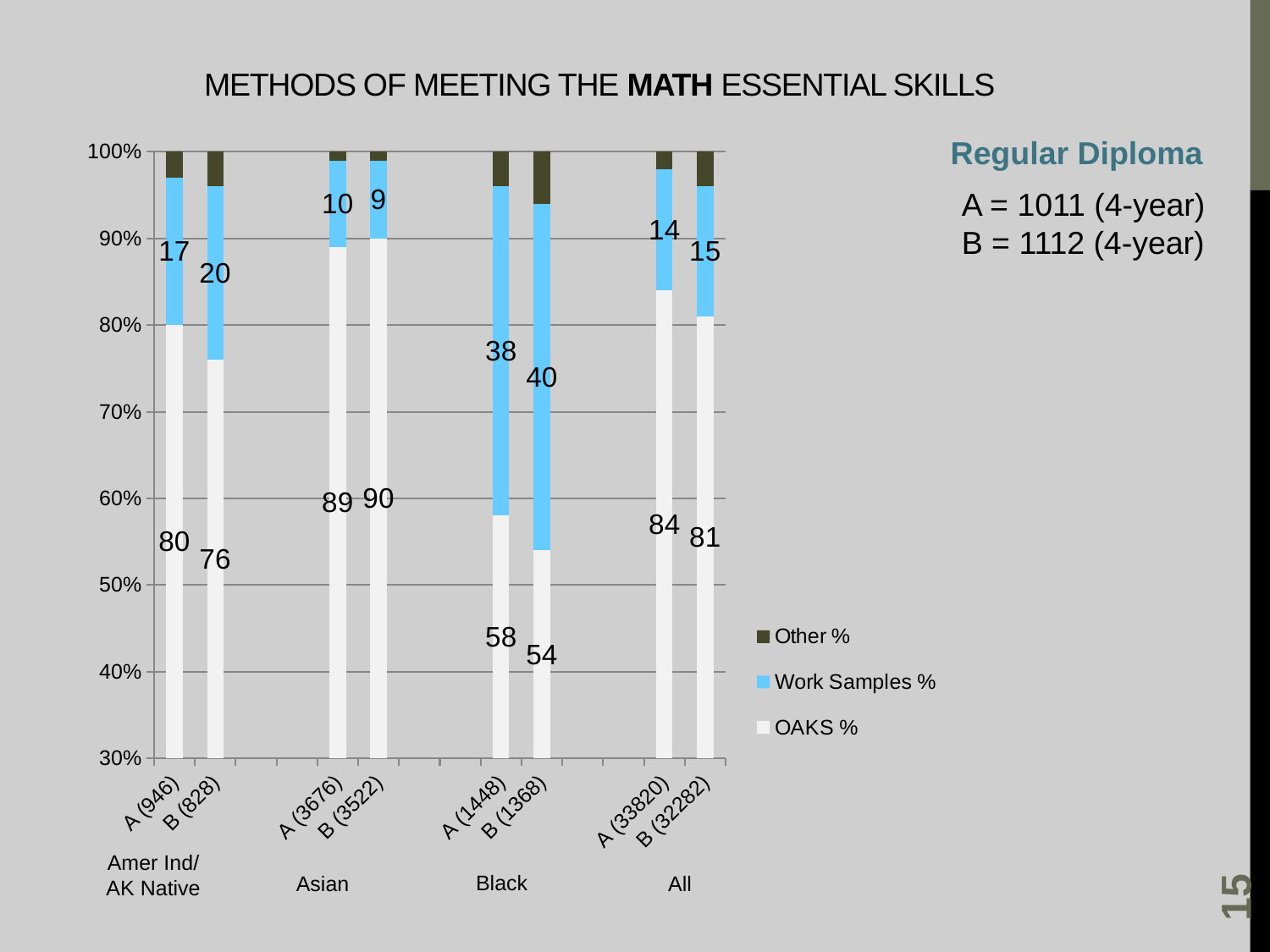
Which bar has the lowest OAKS % value? Black B (1368) Which is larger, the Work Samples % for Black A (1448) or for All A (33820)? Black A (1448) What kind of chart is shown on the slide? Stacked bar chart Which bar has the highest OAKS % value? Asian B (3522) Which series is shown in blue in the legend? Work Samples % How many series does the legend list? 3 What is the OAKS % value for Black A (1448)? 58 What is the OAKS % value for All B (32282)? 81 How many bars are plotted in the chart? 8 What is the Work Samples % value for Asian B (3522)? 9 Which bar has the highest Work Samples % value? Black B (1368) What is the difference between the OAKS % values for Amer Ind/AK Native A (946) and B (828)? 4